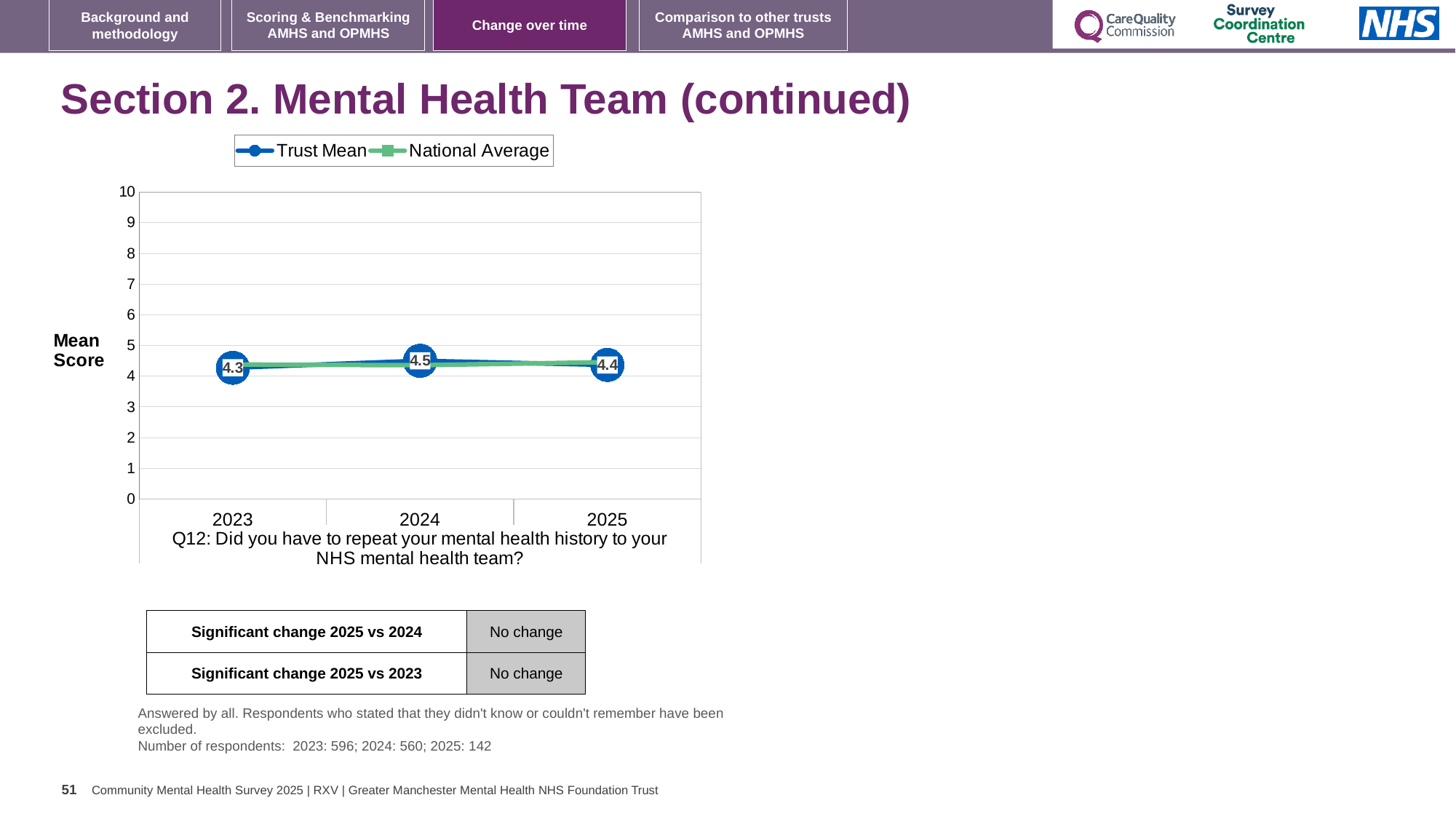
What kind of chart is shown on the slide? line chart What is the Trust Mean score for 2024? 4.5 Which is larger, the Trust Mean for 2025 or for 2023? 2025 What is the difference between the Trust Mean in 2024 and in 2023? 0.2 In which year is the Trust Mean lowest? 2023 What is the Trust Mean score for 2023? 4.3 In which year is the Trust Mean highest? 2024 What is the Trust Mean score for 2025? 4.4 Does the Trust Mean rise or fall from 2024 to 2025? fall How many years are plotted on the x axis? 3 Is the National Average value for 2024 greater or less than 5? less How many series does the legend list? 2